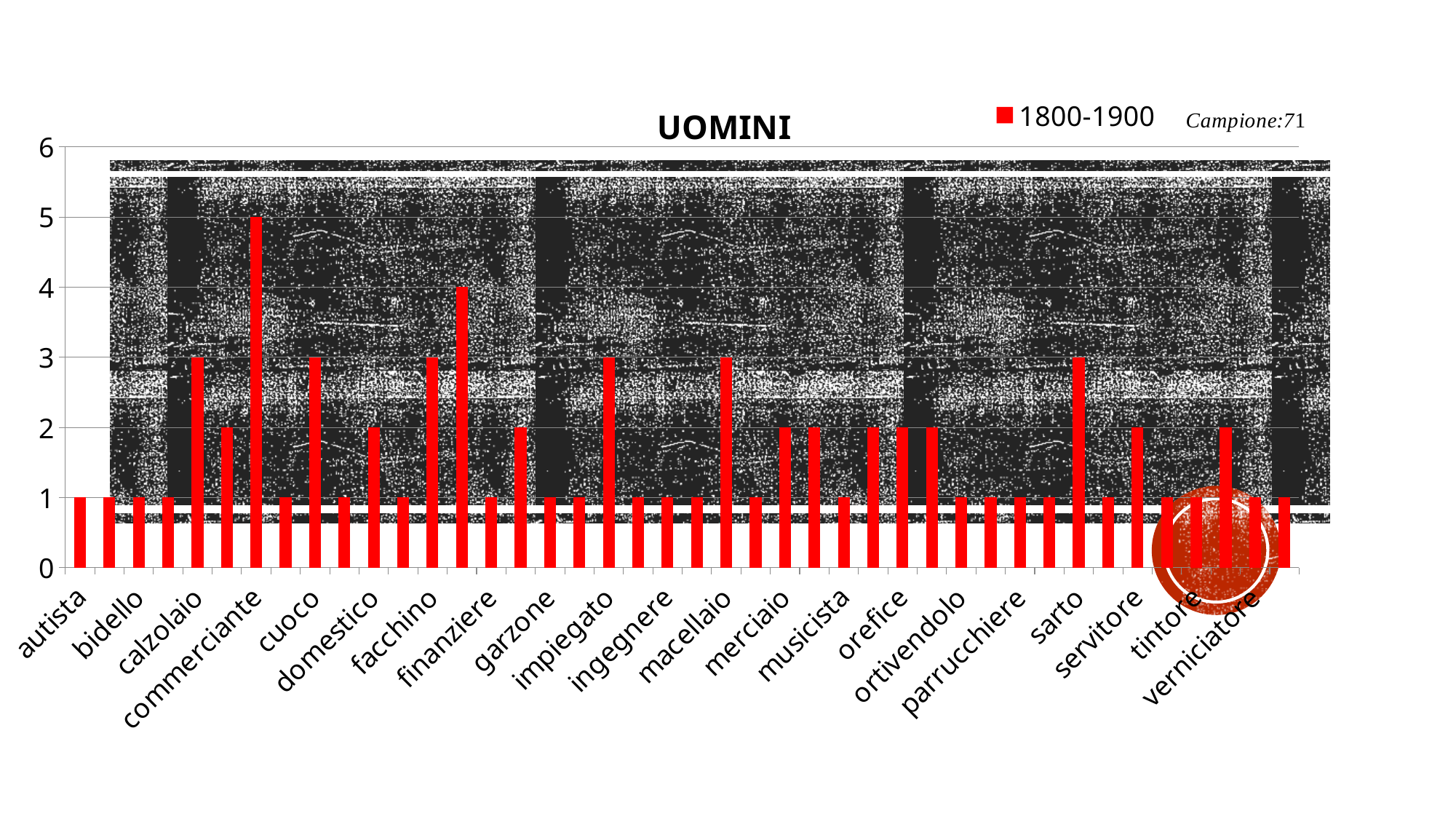
Is the value for autista greater or less than 2? less How many series does the legend list? 1 What is the name of the series shown in the legend? 1800-1900 What type of chart is shown on the slide? bar chart Which is larger, the value for sarto or the value for autista? sarto What is the title of the chart? UOMINI What is the value for commerciante? 5 Is the value for commerciante greater or less than 4? greater Which is larger, the value for commerciante or the value for calzolaio? commerciante Which category has the highest value? commerciante What is the difference between the values for commerciante and calzolaio? 2 What is the value for calzolaio? 3